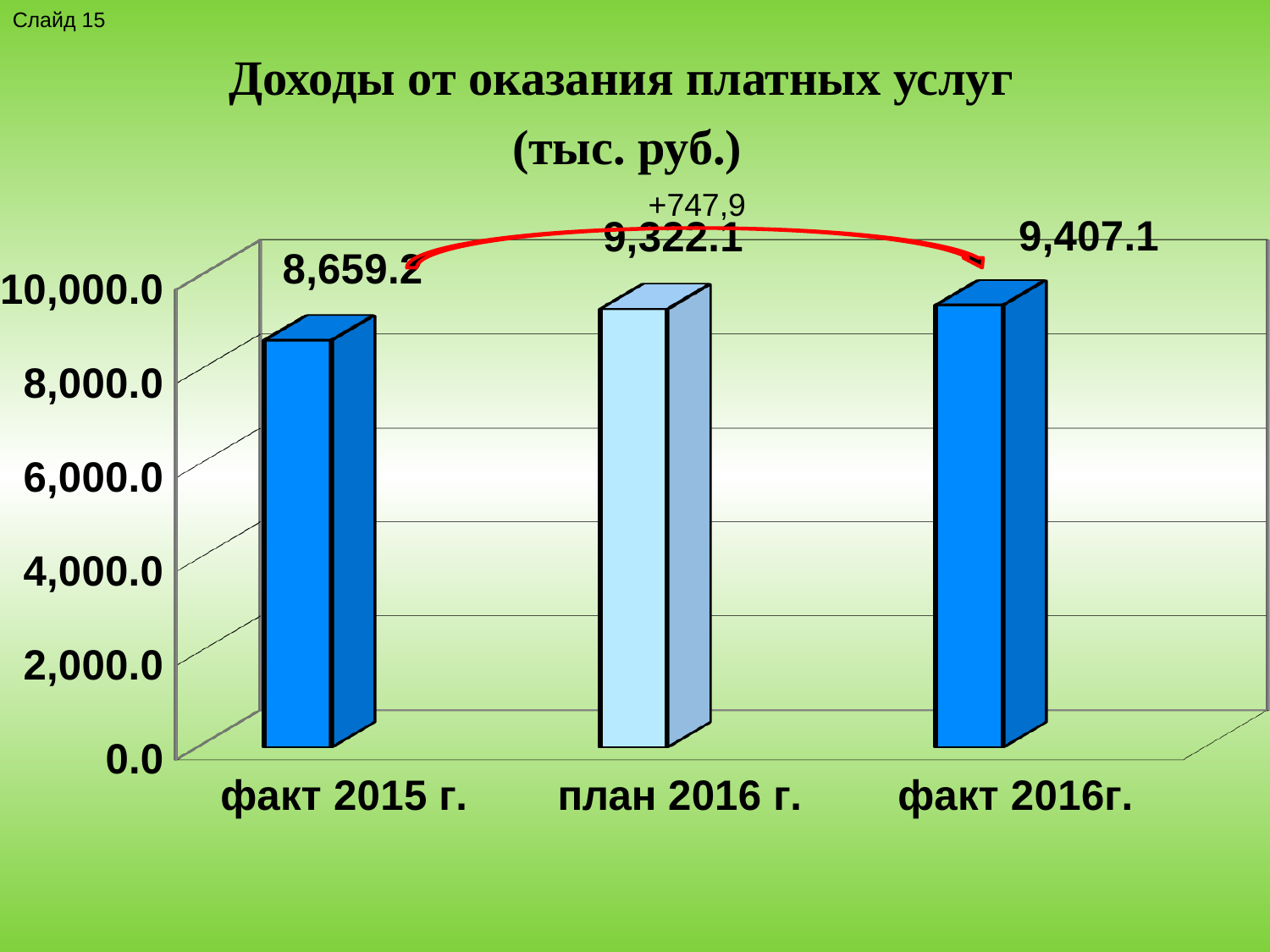
Which is larger, the value for план 2016 г. or the value for факт 2015 г.? план 2016 г. What is the value for факт 2016г.? 9,407.1 Which category has the lowest value? факт 2015 г. What is the value for план 2016 г.? 9,322.1 What is the value for факт 2015 г.? 8,659.2 What kind of chart is shown on the slide? bar chart Is the value for факт 2015 г. greater or less than 8,000.0? greater What is the title of the chart? Доходы от оказания платных услуг (тыс. руб.) How many categories are shown on the chart? 3 What is the difference between the values for факт 2016г. and факт 2015 г.? 747.9 Which category has the highest value? факт 2016г. What is the difference between the values for факт 2016г. and план 2016 г.? 85.0